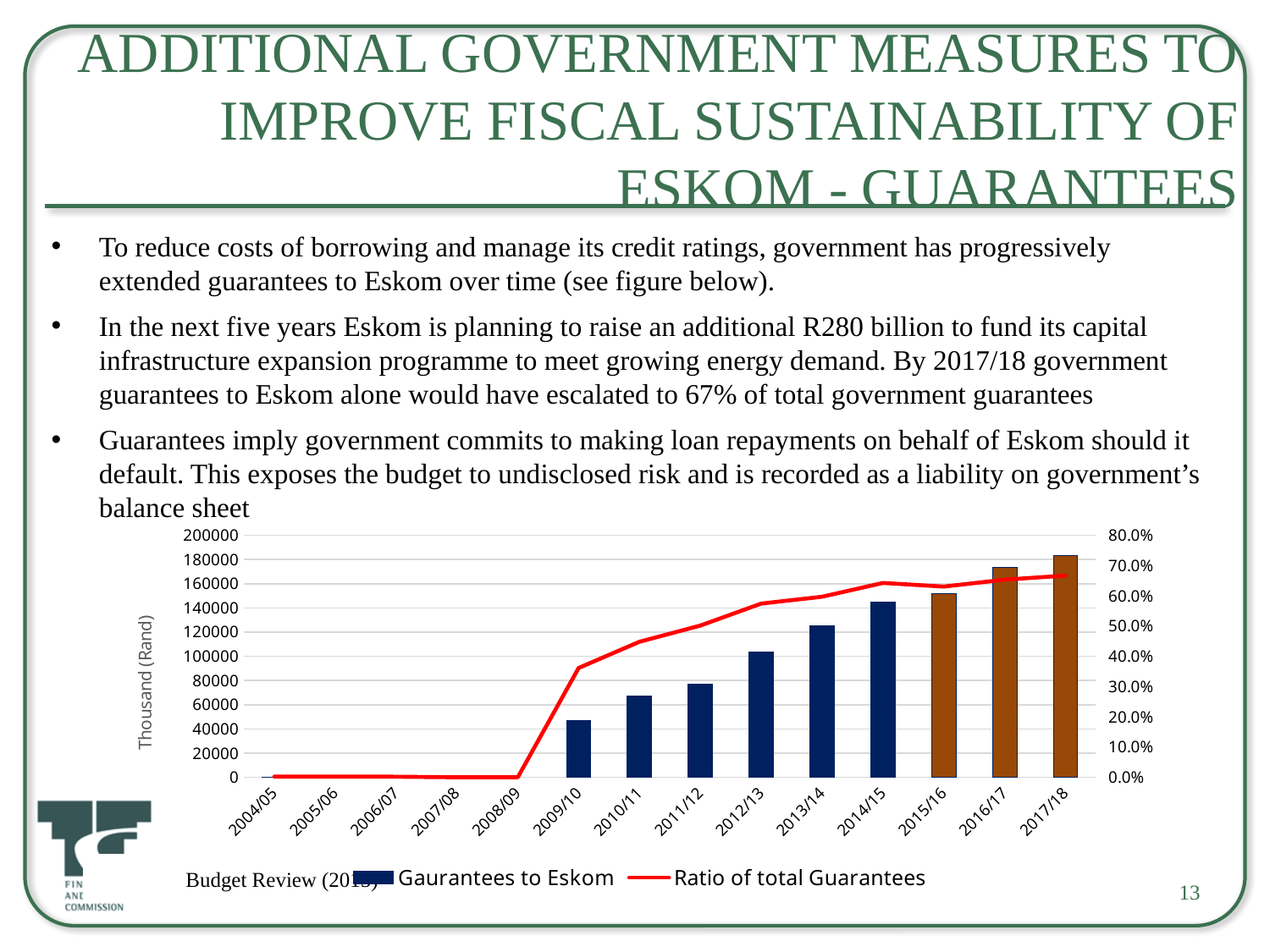
Is the Ratio of total Guarantees for 2009/10 greater or less than 30.0%? greater Is the Ratio of total Guarantees for 2017/18 greater or less than 60.0%? greater Which year has the highest bar for Gaurantees to Eskom? 2017/18 What kind of chart is shown on the slide? A combined bar and line chart Is the Gaurantees to Eskom bar for 2017/18 greater or less than 160000? greater Which year has the larger Gaurantees to Eskom bar, 2010/11 or 2012/13? 2012/13 What is the title of the left vertical axis of the chart? Thousand (Rand) How many fiscal years are shown on the x axis of the chart? 14 Do the Gaurantees to Eskom bars rise or fall from 2009/10 to 2017/18? Rise How many series does the chart legend list? 2